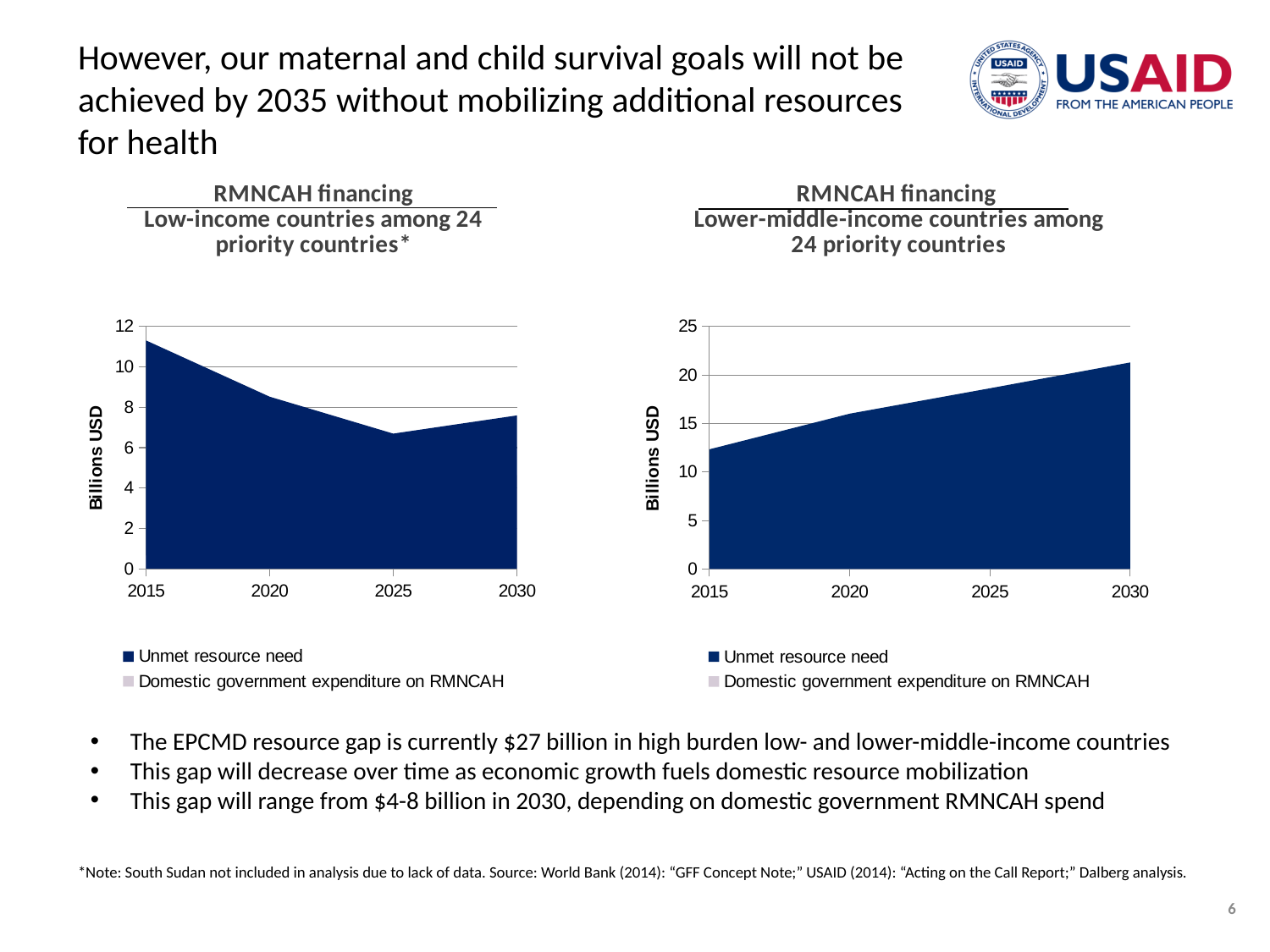
What is the y-axis label of the left chart (Low-income countries)? Billions USD How many series does the legend of the right chart (Lower-middle-income countries) list? 2 In the left chart (Low-income countries), which year has the highest value? 2015 In the left chart (Low-income countries), which year has the lowest value? 2025 In the right chart (Lower-middle-income countries), is the value for 2015 greater or less than 15? less In the right chart (Lower-middle-income countries), do the values rise or fall from 2015 to 2030? rise In the right chart (Lower-middle-income countries), which is larger, the value for 2020 or the value for 2030? 2030 In the left chart (Low-income countries), is the value for 2025 greater or less than 8? less How many years are labelled on the x axis of the left chart (Low-income countries)? 4 What kind of chart is the left chart, 'Low-income countries among 24 priority countries'? area chart In the right chart (Lower-middle-income countries), is the value for 2030 greater or less than 20? greater